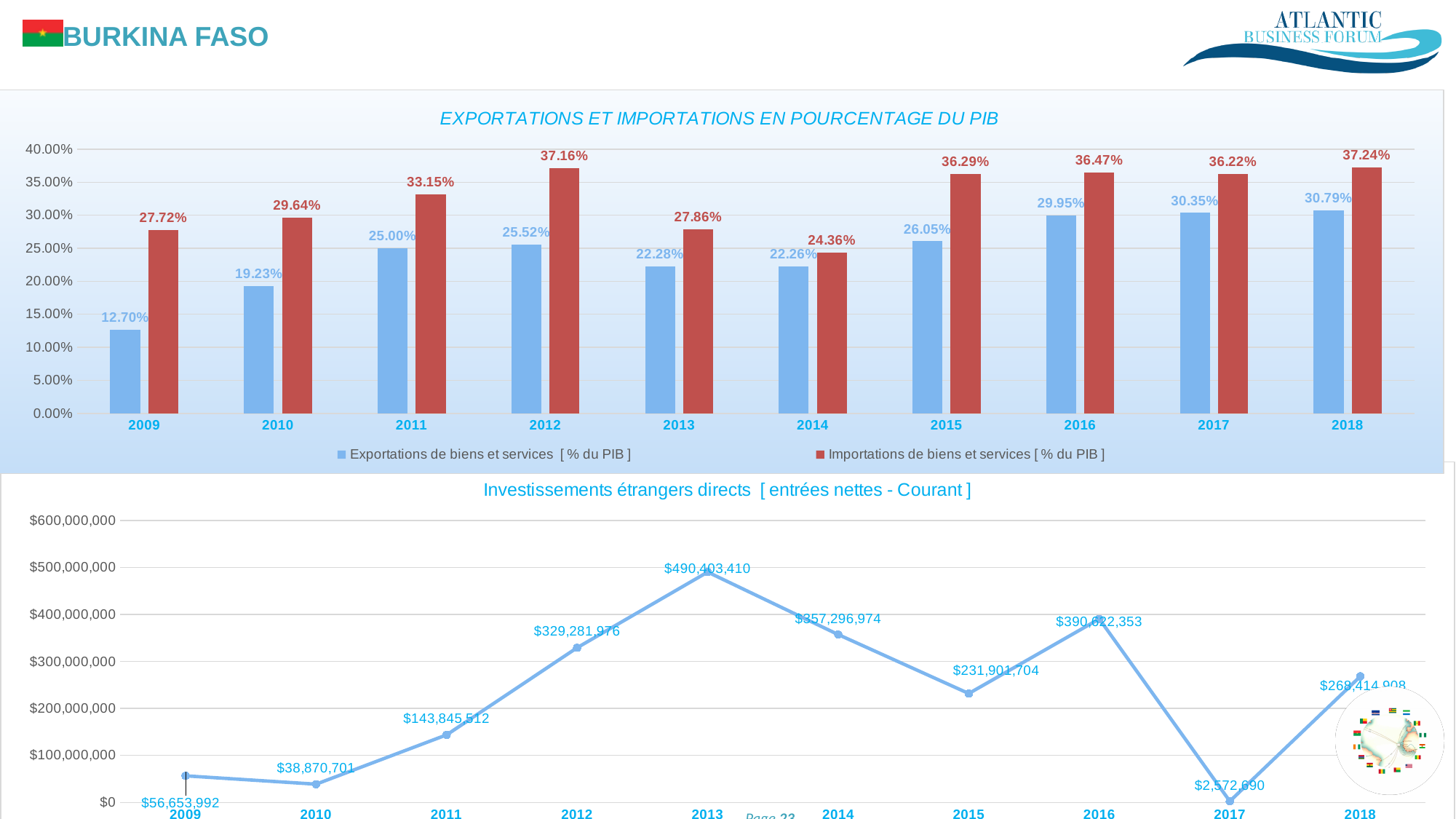
In the top chart 'EXPORTATIONS ET IMPORTATIONS EN POURCENTAGE DU PIB', which year has the highest Importations value? 2018 In the bottom chart 'Investissements étrangers directs', which year has the lowest value? 2017 What kind of chart is the bottom chart 'Investissements étrangers directs'? Line chart In the bottom chart 'Investissements étrangers directs', is the value for 2011 greater or less than $200,000,000? less In the top chart 'EXPORTATIONS ET IMPORTATIONS EN POURCENTAGE DU PIB', what is the value of Importations de biens et services for 2012? 37.16% In the top chart 'EXPORTATIONS ET IMPORTATIONS EN POURCENTAGE DU PIB', which year has the lowest Exportations value? 2009 In the bottom chart 'Investissements étrangers directs', what is the value for 2013? $490,403,410 In the top chart 'EXPORTATIONS ET IMPORTATIONS EN POURCENTAGE DU PIB', how many series does the legend list? 2 In the top chart 'EXPORTATIONS ET IMPORTATIONS EN POURCENTAGE DU PIB', what is the difference between Importations and Exportations in 2014? 2.10% In the top chart 'EXPORTATIONS ET IMPORTATIONS EN POURCENTAGE DU PIB', what is the value of Exportations de biens et services for 2009? 12.70% In the bottom chart 'Investissements étrangers directs', is the value for 2012 larger or smaller than the value for 2015? Larger In the top chart 'EXPORTATIONS ET IMPORTATIONS EN POURCENTAGE DU PIB', how many years are shown on the x axis? 10